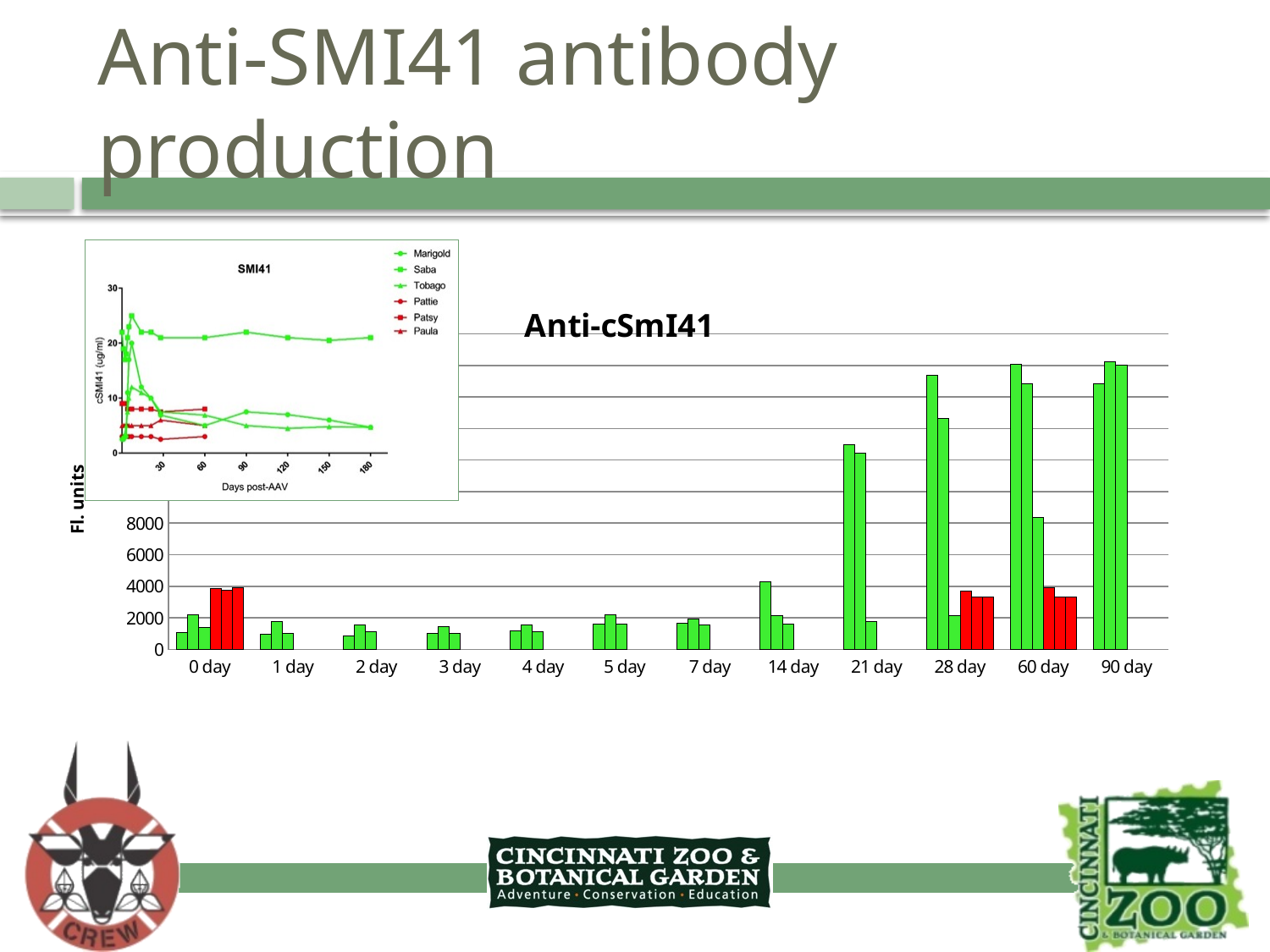
In the Anti-cSmI41 bar chart, which has the taller tallest bar: 90 day or 7 day? 90 day What is the y-axis label of the Anti-cSmI41 bar chart? Fl. units In the Anti-cSmI41 bar chart, is the tallest bar at 3 day greater or less than 2000? less How many day categories are shown on the x axis of the Anti-cSmI41 bar chart? 12 What kind of chart is the inset SMI41 chart? line chart In the Anti-cSmI41 bar chart, is the tallest bar at 28 day greater or less than 8000? greater What kind of chart is the Anti-cSmI41 chart? bar chart In the Anti-cSmI41 bar chart, is the tallest bar at 7 day greater or less than 4000? less What is the x-axis label of the inset SMI41 line chart? Days post-AAV In the Anti-cSmI41 bar chart, do the green bars generally rise or fall from 0 day to 90 day? rise How many series does the legend of the inset SMI41 chart list? 6